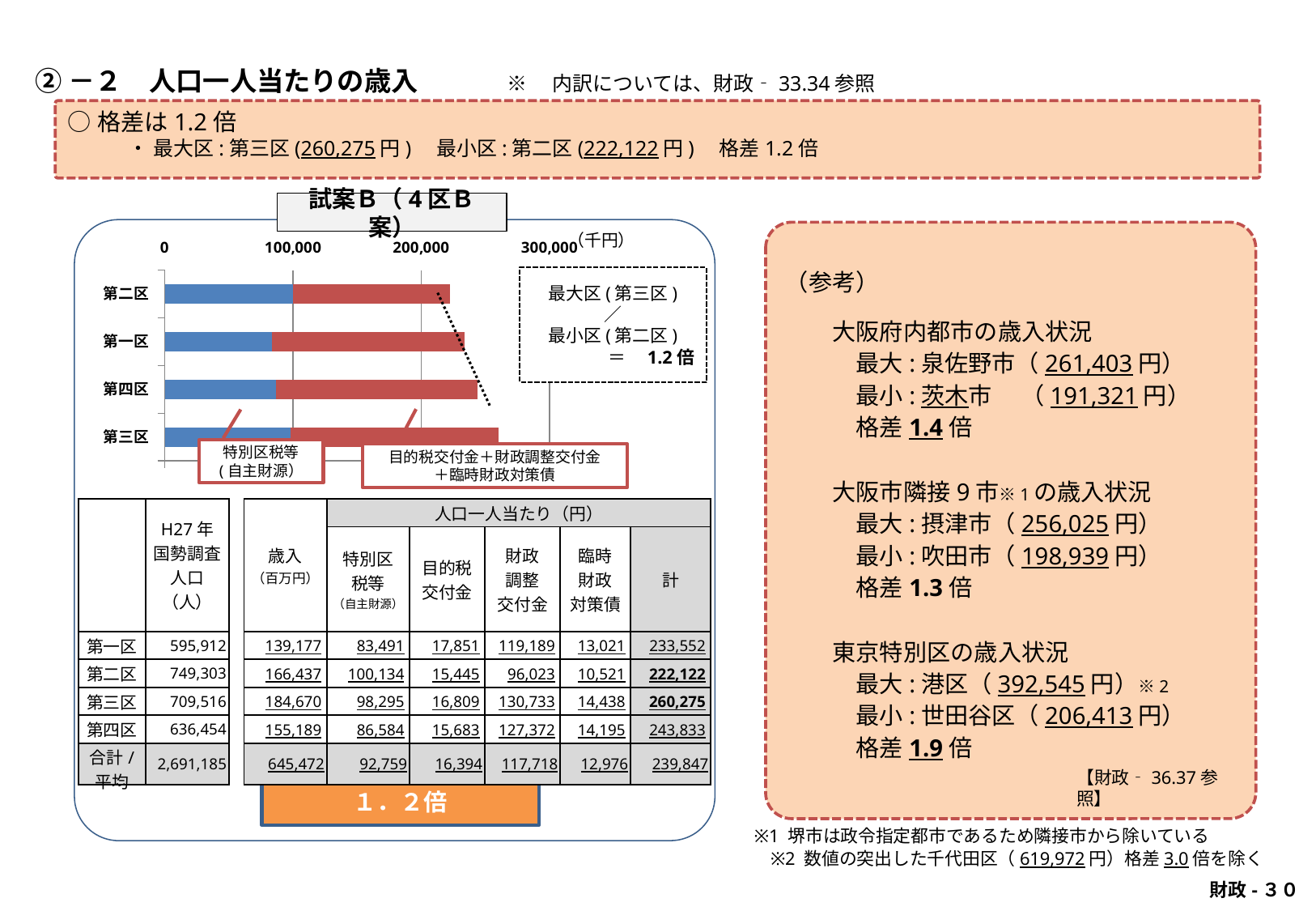
What ratio between the largest and smallest district is shown in the callout box on the chart? 1.2倍 How many districts (categories) are plotted in the bar chart? 4 Is the blue segment (特別区税等) for 第一区 greater or less than 100,000? less Which district has the shortest bar in the chart? 第二区 Do the bars get longer or shorter going from the top district (第二区) to the bottom district (第三区)? longer What kind of chart is shown on the slide? bar chart Which district has the longest bar in the chart? 第三区 Is the total bar for 第二区 greater or less than 300,000? less How many series does the bar chart show? 2 Is the total bar for 第三区 greater or less than 200,000? greater Which bar is longer, 第三区 or 第二区? 第三区 What does the red series in the bar chart represent, according to its label? 目的税交付金＋財政調整交付金＋臨時財政対策債